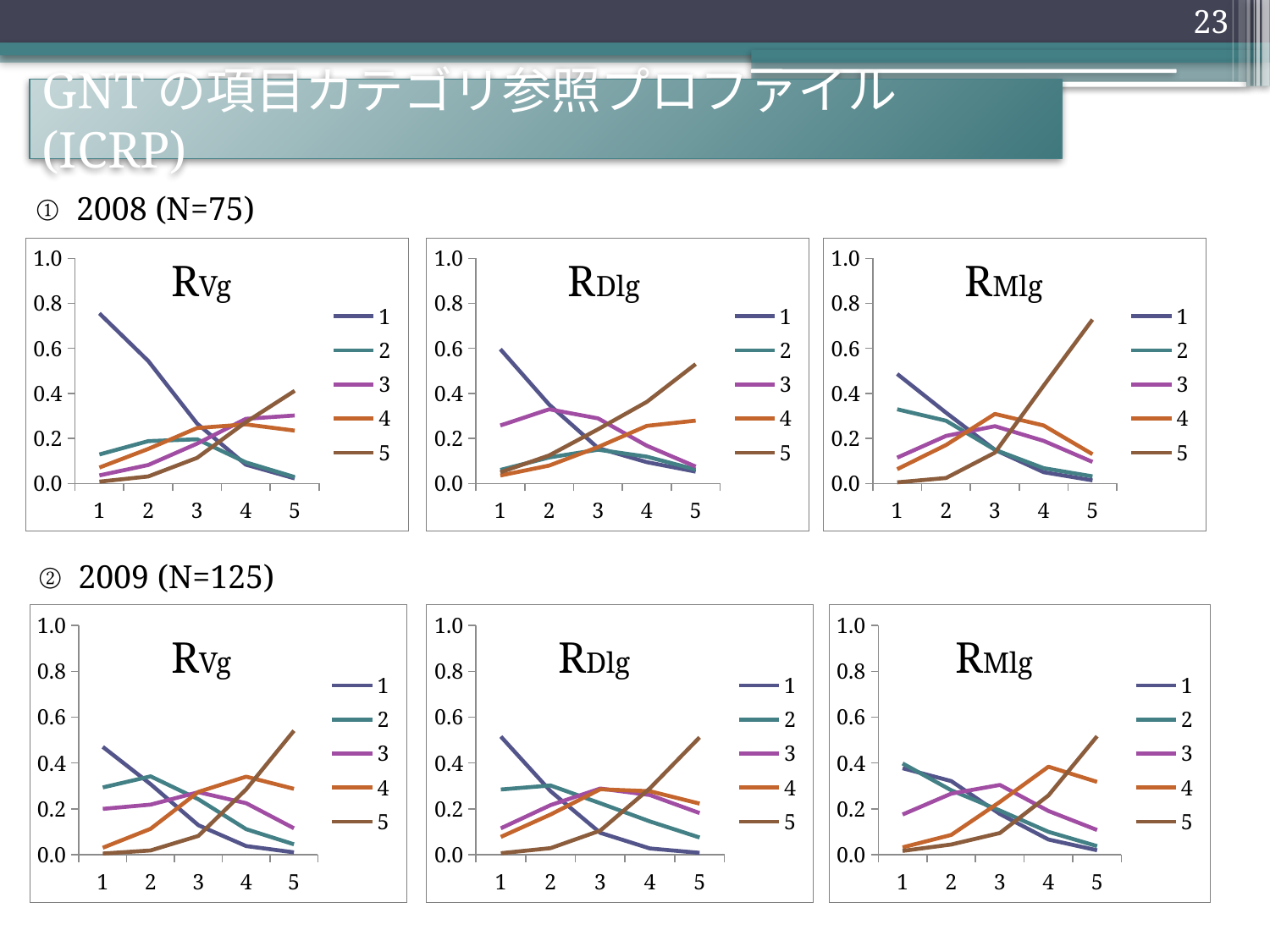
In the 2008 RDlg chart (top middle), is the value of series 5 at x=1 greater or less than 0.2? less How many charts are shown on the slide? 6 What kind of chart is the 2008 RVg chart (top left)? line chart How many points are on the x axis of the 2009 RMlg chart (bottom right)? 5 In the 2009 RMlg chart (bottom right), does series 5 rise or fall from x=1 to x=5? rise What is the title of the top-right chart in the 2008 row? RMlg In the 2009 RVg chart (bottom left), is the value of series 5 at x=5 greater or less than 0.4? greater In the 2008 RVg chart (top left), is the value of series 1 at x=1 greater or less than 0.6? greater How many series does the legend of the 2008 RDlg chart (top middle) list? 5 In the 2008 RVg chart (top left), does series 1 rise or fall from x=1 to x=5? fall